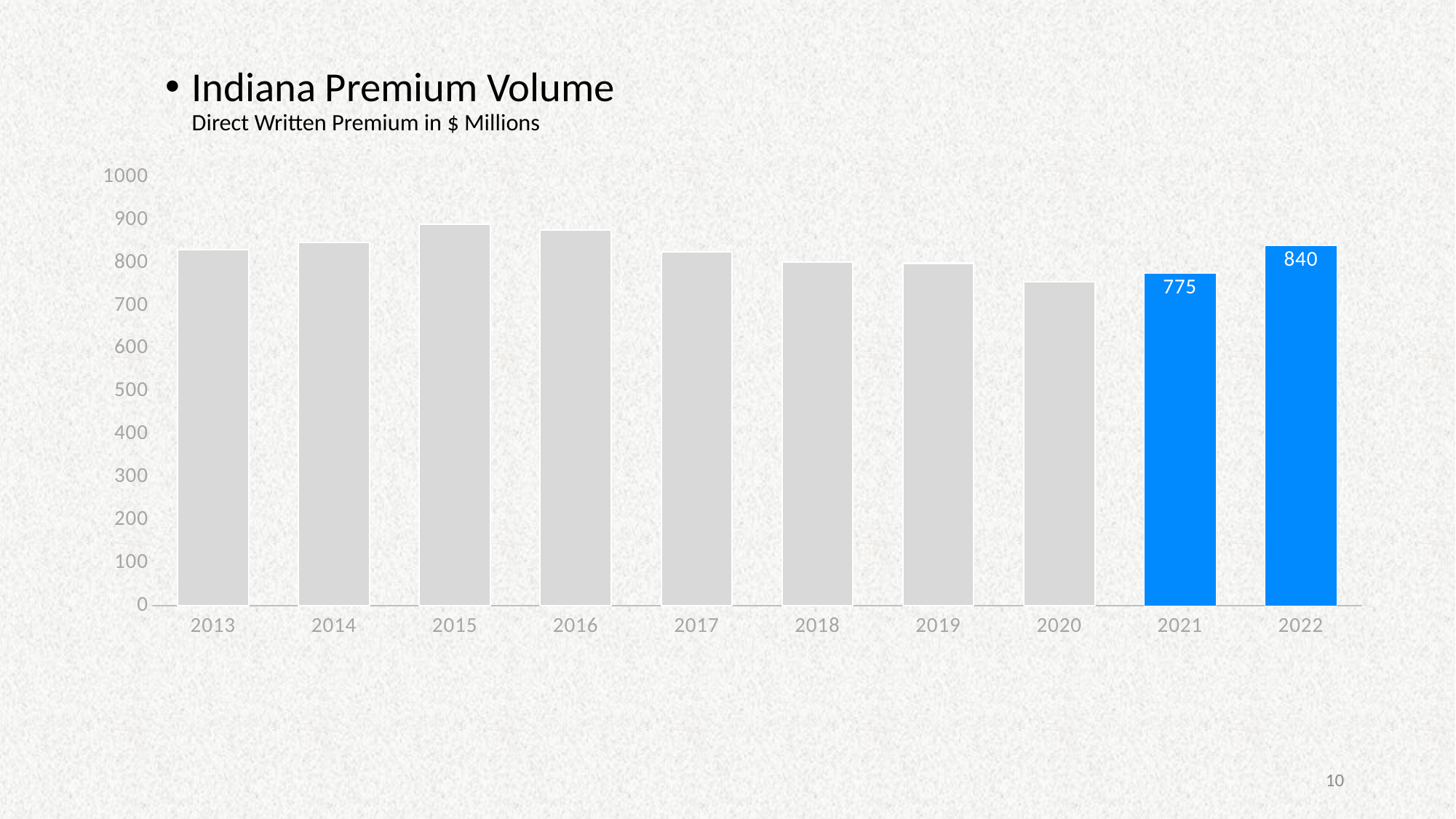
Which is larger, the value for 2021 or the value for 2022? 2022 Is the value for 2013 greater or less than 700? greater What kind of chart is shown on the slide? bar chart What is the value for 2022? 840 What unit does the subtitle say the premium values are in? $ Millions Is the value for 2020 greater or less than 800? less Which year has the lowest value? 2020 How many years are shown on the x axis? 10 What is the difference between the values for 2022 and 2021? 65 What is the value for 2021? 775 Which year has the highest value? 2015 Is the value for 2016 greater or less than 800? greater